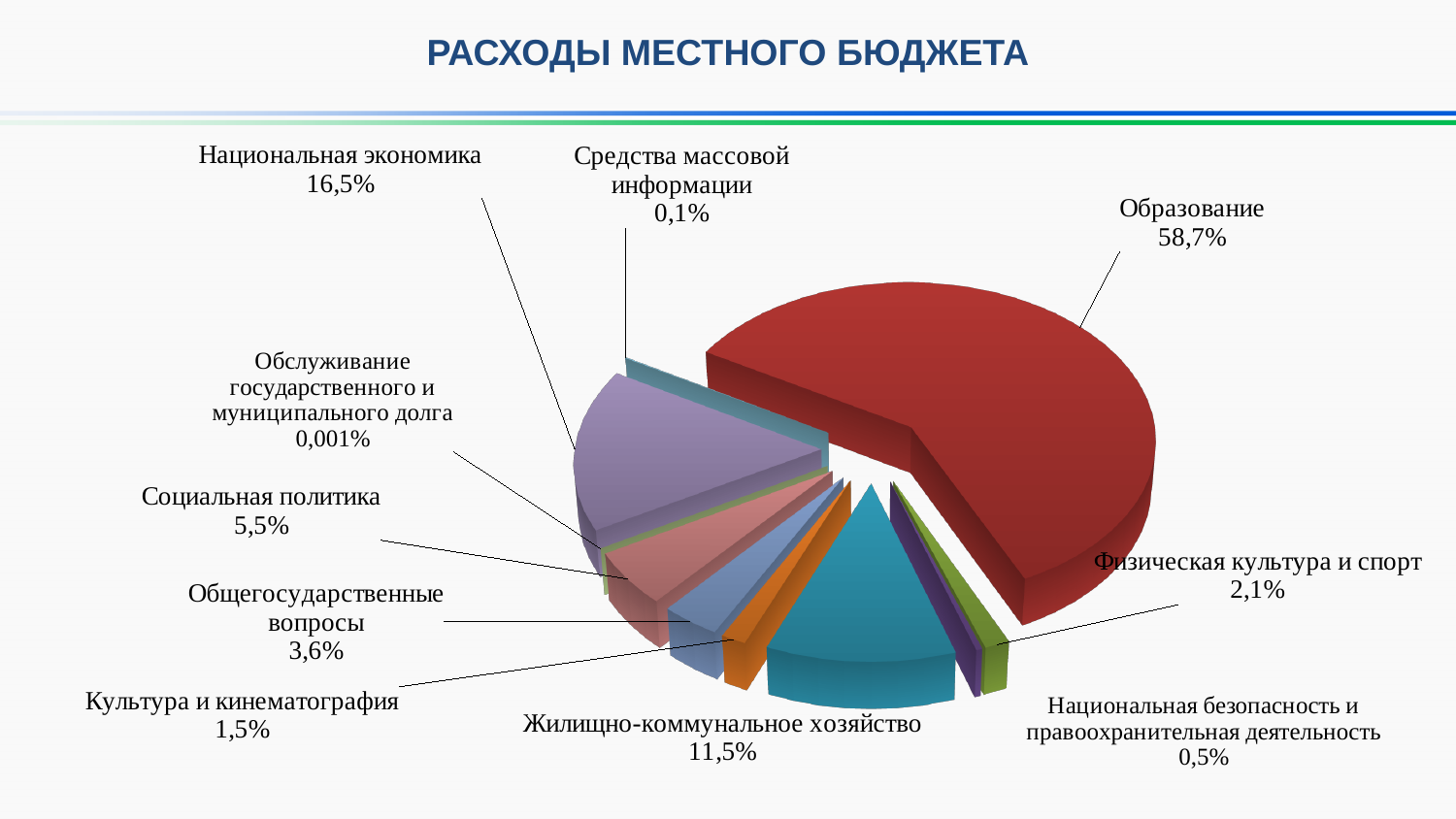
Which category has the smallest share of the pie? Обслуживание государственного и муниципального долга What is the difference between the shares of Образование and Национальная экономика? 42,2% What is the value shown for Национальная безопасность и правоохранительная деятельность? 0,5% What is the value shown for Национальная экономика? 16,5% What is the title of the chart? РАСХОДЫ МЕСТНОГО БЮДЖЕТА What type of chart is shown on the slide? Pie chart What is the value shown for Жилищно-коммунальное хозяйство? 11,5% Which category has the largest share of the pie? Образование What share of the local budget expenses goes to Образование? 58,7% Which is larger: Социальная политика or Общегосударственные вопросы? Социальная политика What is the value shown for Обслуживание государственного и муниципального долга? 0,001% How many categories are shown in the pie chart? 10